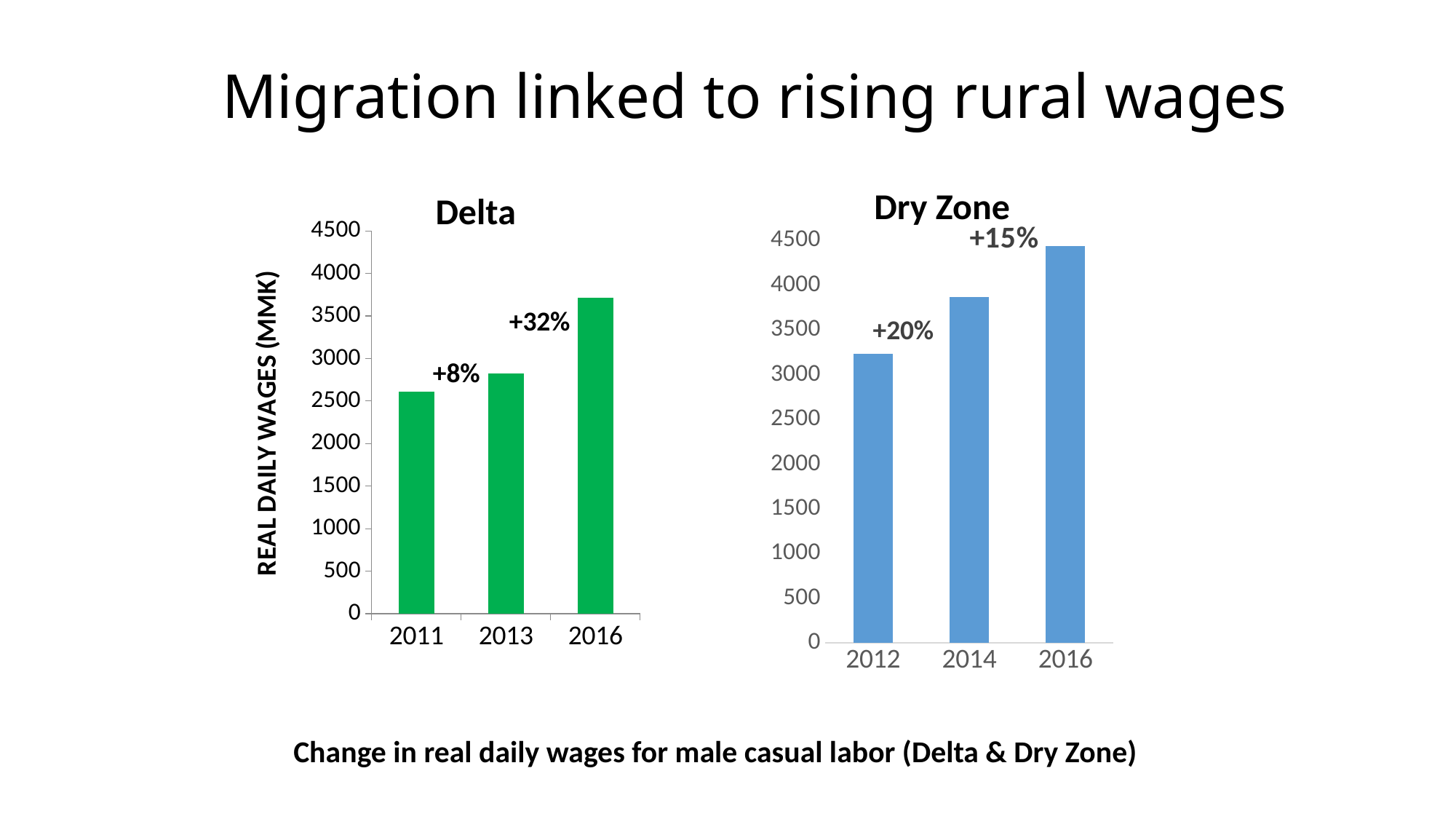
In the Dry Zone chart, is the value for 2012 greater or less than 3000? greater What kind of chart is the Dry Zone chart? Bar chart In the Delta chart, which year has the highest real daily wage? 2016 How many bars are shown in the Delta chart? 3 In the Dry Zone chart, what percentage change is labelled between 2012 and 2014? +20% In the Delta chart, do real daily wages rise or fall from 2011 to 2016? Rise In the Dry Zone chart, what percentage change is labelled between 2014 and 2016? +15% In the Delta chart, is the value for 2016 greater or less than 3500? greater In the Delta chart, what percentage change is labelled between 2011 and 2013? +8% In the Delta chart, what percentage change is labelled between 2013 and 2016? +32% In the Dry Zone chart, which year has the lowest real daily wage? 2012 In the Dry Zone chart, is the value for 2014 greater or less than 4000? less